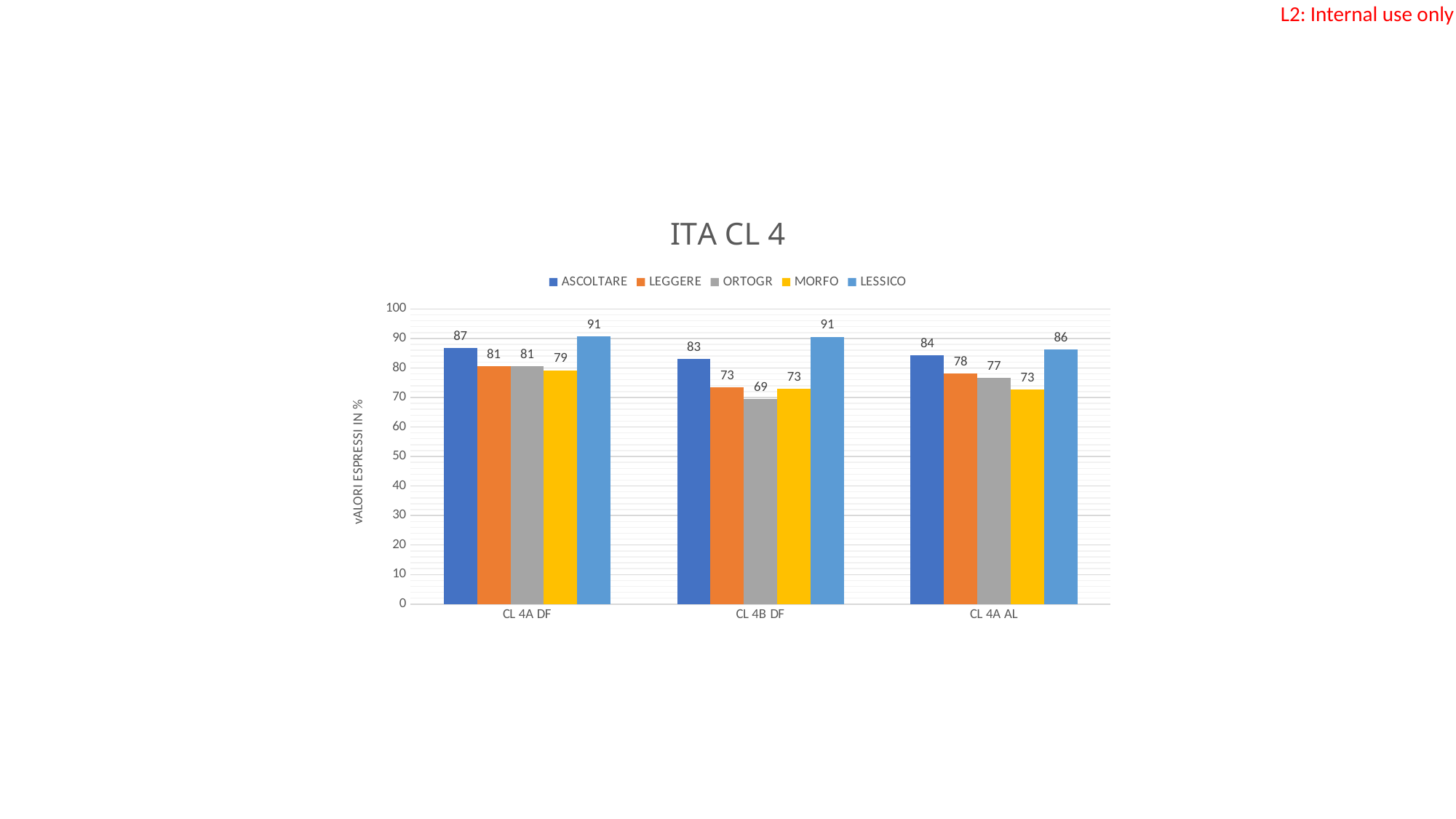
What is the value for ASCOLTARE in CL 4A DF? 87 What is the value for ORTOGR in CL 4B DF? 69 What is the title of the chart? ITA CL 4 What is the difference between the LESSICO and ORTOGR values in CL 4B DF? 22 Which series has the highest value in CL 4B DF? LESSICO How many series does the legend list? 5 Which series has the lowest value in CL 4A AL? MORFO What kind of chart is shown? bar chart What is the label of the vertical axis? vALORI ESPRESSI IN % What is the value for LESSICO in CL 4A AL? 86 How many categories are shown on the x axis? 3 Which is larger, the LEGGERE value in CL 4A DF or the LEGGERE value in CL 4A AL? CL 4A DF